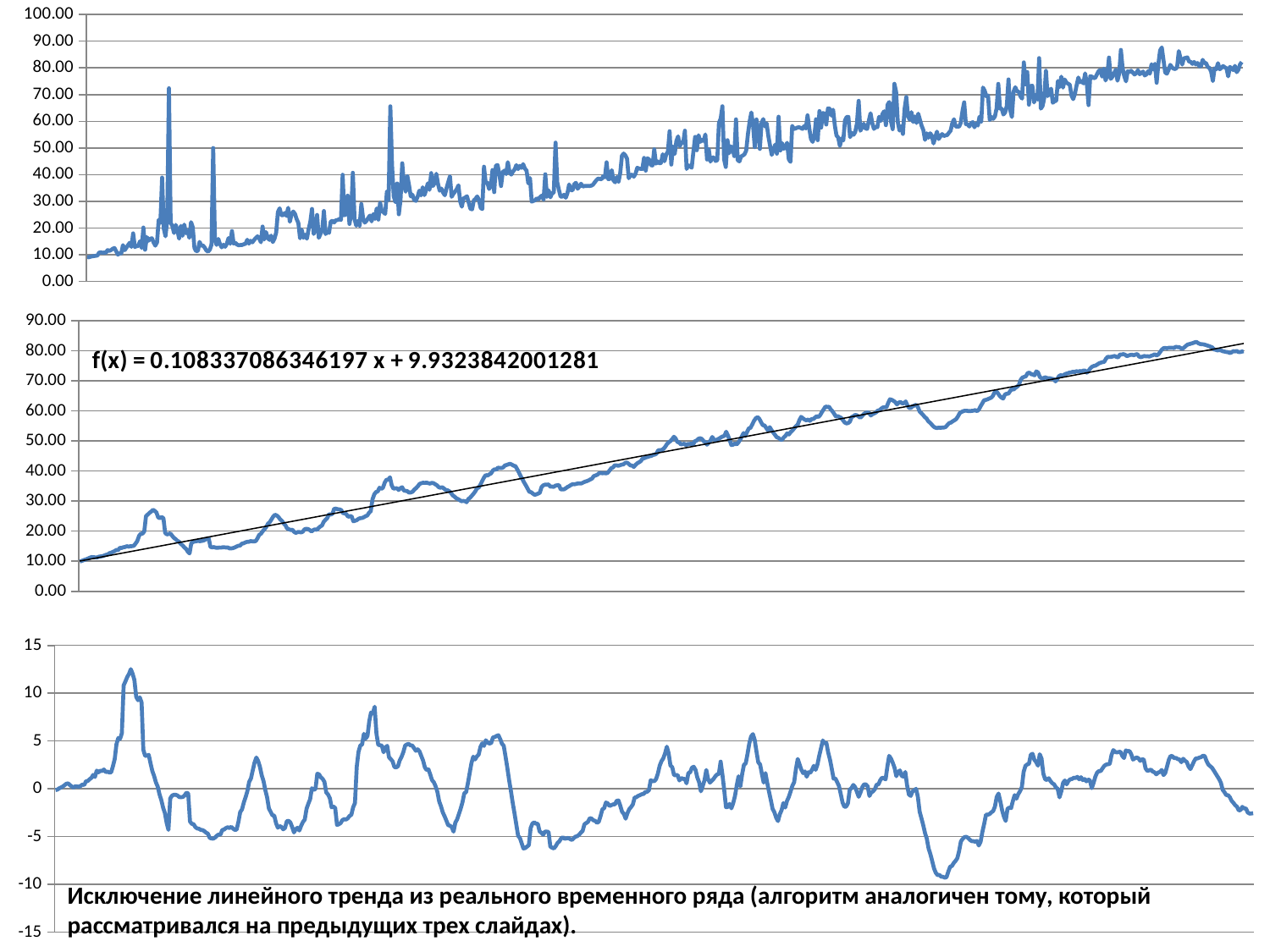
In the middle chart, do the values generally rise or fall from left to right? rise In the top chart, is the highest value of the series greater or less than 70.00? greater In the middle chart, what is the intercept of the trend line equation? 9.9323842001281 In the middle chart, what is the equation of the fitted trend line shown on the chart? f(x) = 0.108337086346197 x + 9.9323842001281 In the middle chart, what is the slope coefficient of the trend line equation? 0.108337086346197 In the top chart, is the value at the right end of the series higher or lower than the value at the left end? higher How many charts are shown on the slide? 3 What kind of chart is the top chart on the slide? line chart In the bottom chart, is the lowest value of the series greater or less than -5? less In the bottom chart, is the highest value of the series greater or less than 10? greater In the top chart, do the values generally rise or fall from left to right? rise